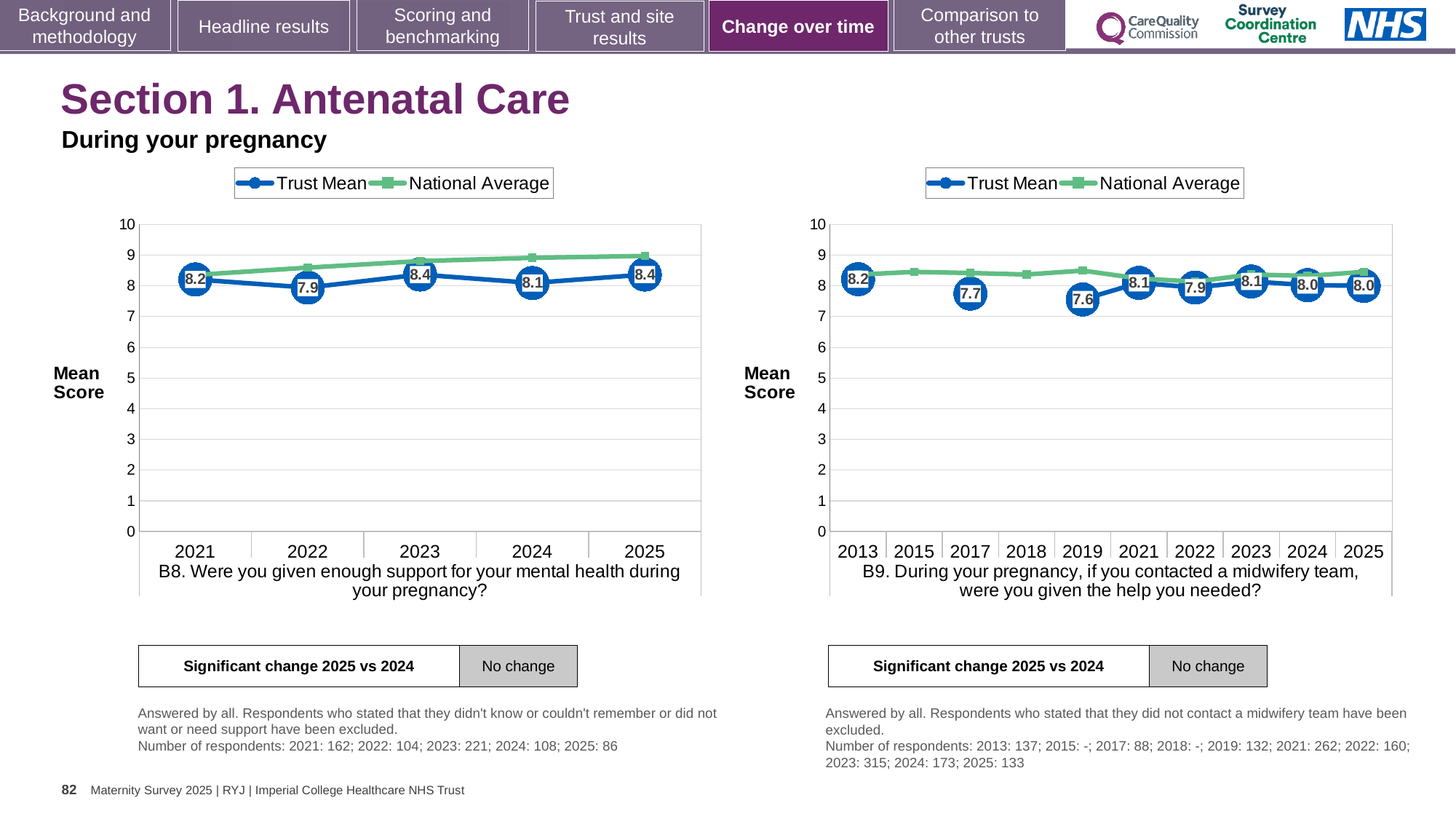
In the B9 chart on the right, is the National Average for 2025 greater or less than 7? greater In the B9 chart on the right, is the Trust Mean for 2021 or for 2022 larger? 2021 In the B8 chart on the left, what is the Trust Mean for 2022? 7.9 In the B8 chart on the left, which year has the lowest Trust Mean? 2022 In the B8 chart on the left, what is the Trust Mean for 2025? 8.4 In the B9 chart on the right, what is the Trust Mean for 2019? 7.6 In the B8 chart on the left, how many years are shown on the x axis? 5 How many series does the legend of the B9 chart on the right list? 2 In the B9 chart on the right, which year has the lowest Trust Mean? 2019 In the B8 chart on the left, what is the difference between the Trust Mean in 2023 and in 2022? 0.5 In the B9 chart on the right, what is the Trust Mean for 2013? 8.2 What kind of chart is the B8 chart on the left? Line chart